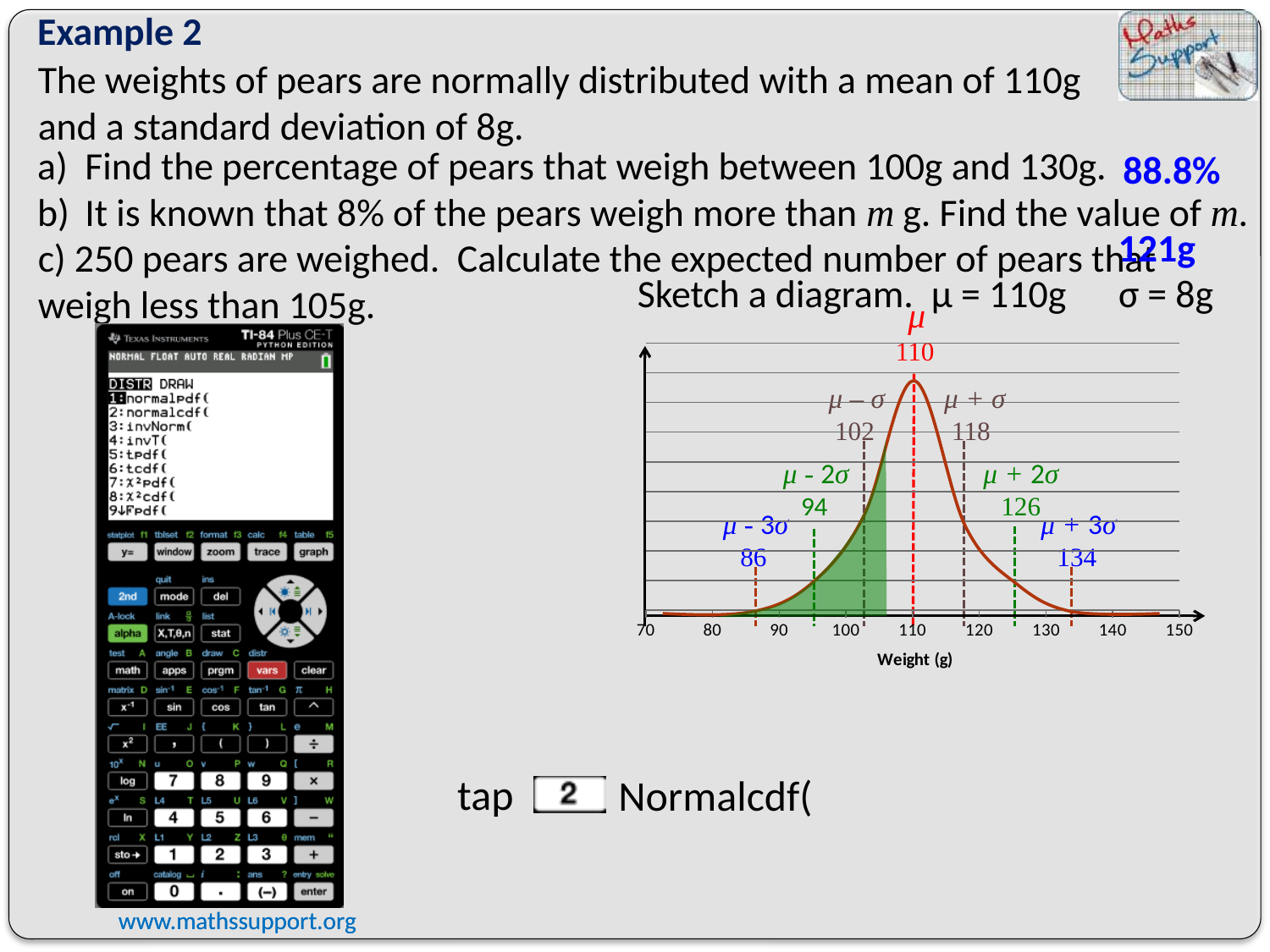
What weight is labelled at μ − 2σ on the chart? 94 What weight is labelled at μ − 3σ on the chart? 86 What is the difference between the weights labelled at μ + 3σ and μ − 3σ? 48 At which labelled weight does the curve reach its highest point? 110 What weight is labelled at μ + 3σ on the chart? 134 What is the title of the horizontal axis on the chart? Weight (g) How does the curve behave as weight increases from 70 to 150? It rises to a peak at 110 and then falls What is the lowest value shown on the horizontal axis of the chart? 70 What value is labelled at the peak of the curve, marked μ? 110 What weight is labelled at μ + 2σ on the chart? 126 What weight is labelled at μ + σ on the chart? 118 What weight is labelled at μ − σ on the chart? 102